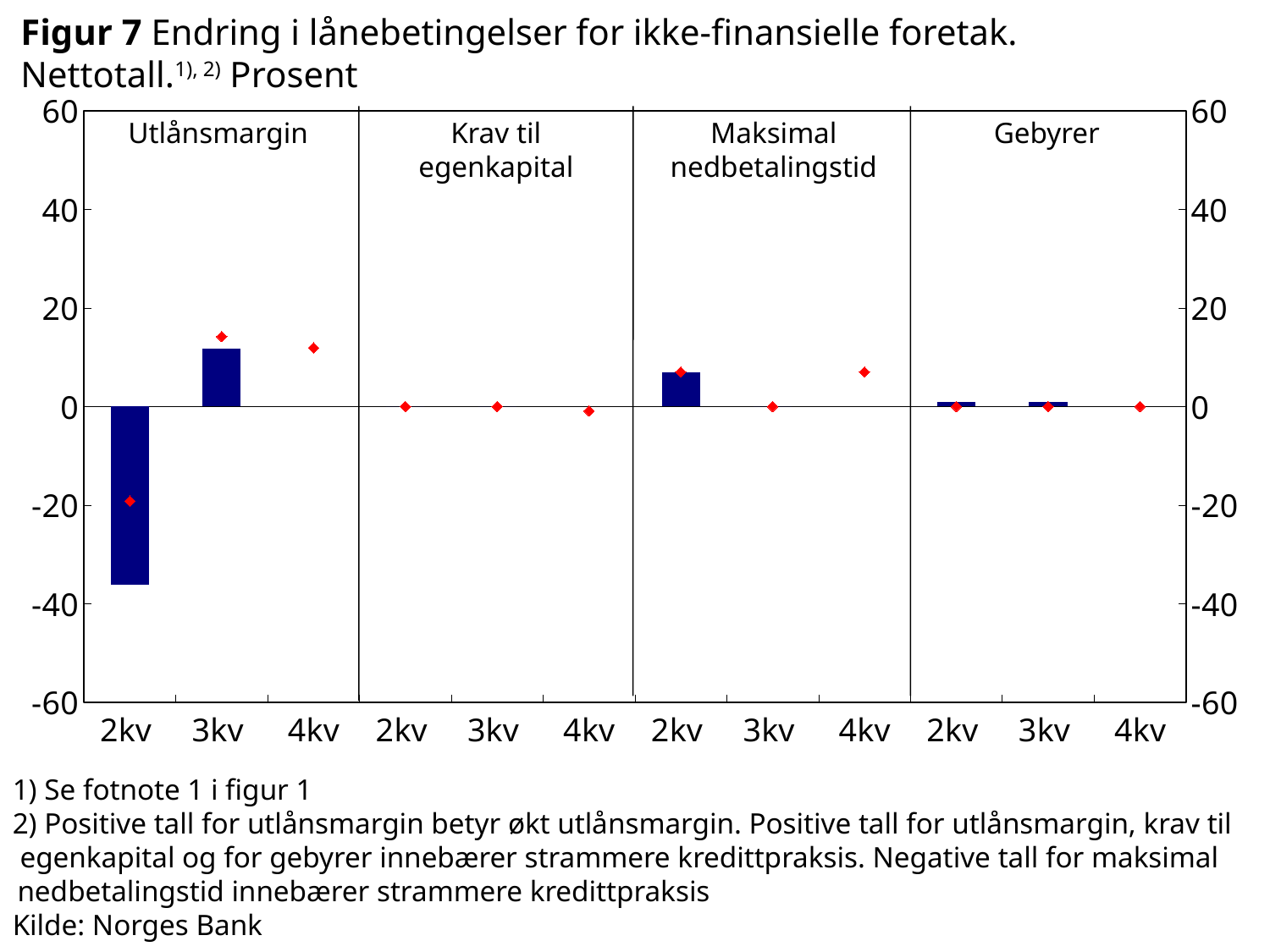
In the Utlånsmargin panel, which quarter has the lowest bar? 2kv Is the bar for 2kv in the Utlånsmargin panel greater or less than -20? less Which is larger: the 3kv bar in the Utlånsmargin panel or the 2kv bar in the Maksimal nedbetalingstid panel? 3kv bar in Utlånsmargin Is the bar for 3kv in the Utlånsmargin panel greater or less than 20? less Is the bar for 2kv in the Maksimal nedbetalingstid panel greater or less than 0? greater How many panels (loan condition categories) does the chart have? 4 Which panel contains the lowest bar in the chart? Utlånsmargin Which is larger: the 2kv bar in the Utlånsmargin panel or the 2kv bar in the Gebyrer panel? 2kv bar in Gebyrer How many quarters are shown on the x axis within each panel? 3 What kind of chart is shown in Figur 7? Combination chart (bars with diamond markers) Which panel contains the highest bar in the chart? Utlånsmargin What is the source given for the chart? Norges Bank